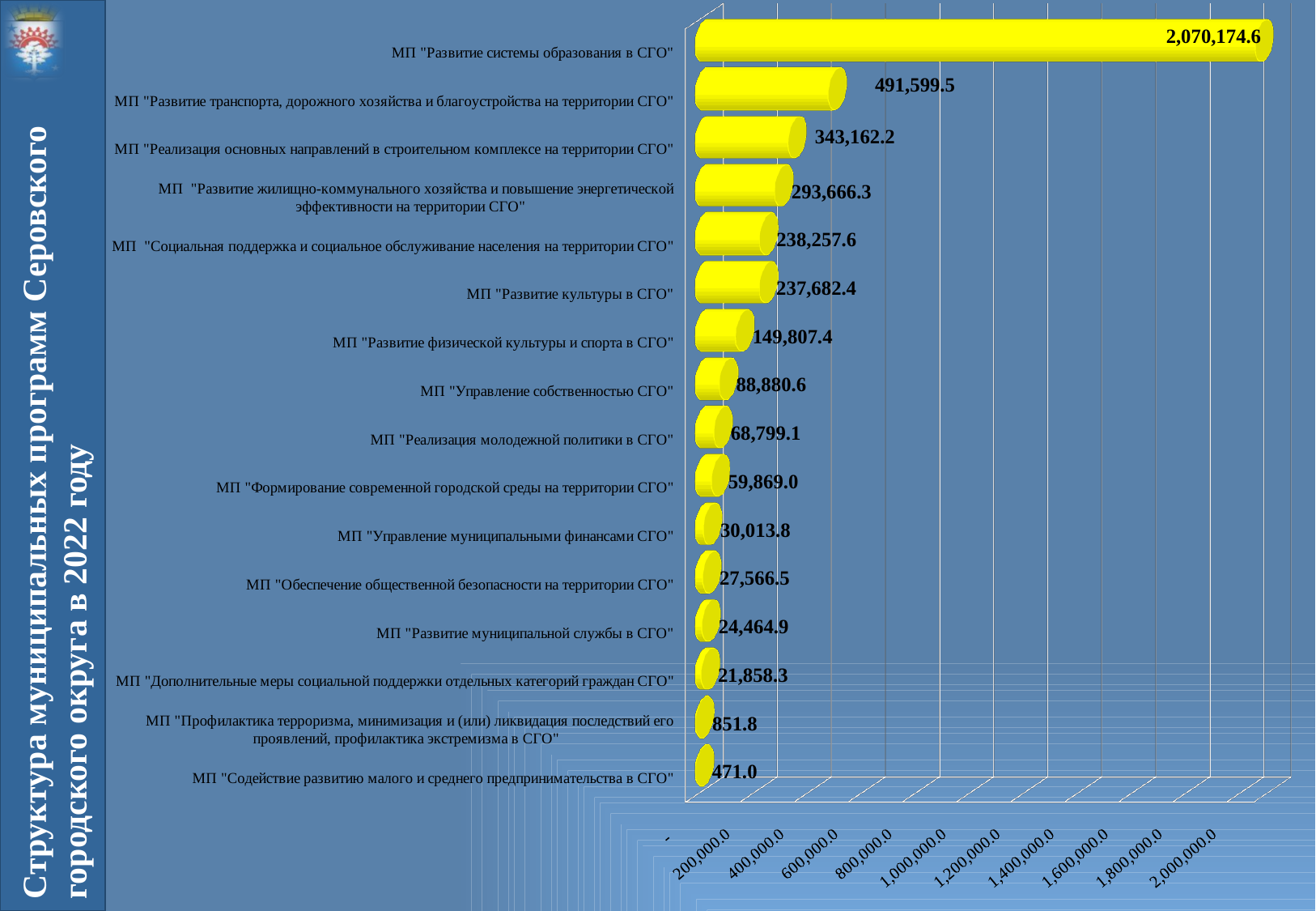
Is the value for МП "Развитие транспорта, дорожного хозяйства и благоустройства на территории СГО" greater or less than 400,000.0? greater What is the value for МП "Управление собственностью СГО"? 88,880.6 Which program has the lowest value? МП "Содействие развитию малого и среднего предпринимательства в СГО" What is the difference between the values for МП "Развитие транспорта, дорожного хозяйства и благоустройства на территории СГО" and МП "Реализация основных направлений в строительном комплексе на территории СГО"? 148,437.3 What is the difference between the values for МП "Социальная поддержка и социальное обслуживание населения на территории СГО" and МП "Развитие культуры в СГО"? 575.2 How many programs (bars) are shown in the chart? 16 What is the value for МП "Развитие культуры в СГО"? 237,682.4 What is the value for МП "Содействие развитию малого и среднего предпринимательства в СГО"? 471.0 What is the value for МП "Развитие системы образования в СГО"? 2,070,174.6 Which is larger: the value for МП "Развитие физической культуры и спорта в СГО" or МП "Реализация молодежной политики в СГО"? МП "Развитие физической культуры и спорта в СГО" Which program has the highest value? МП "Развитие системы образования в СГО" What kind of chart is shown on the slide? bar chart